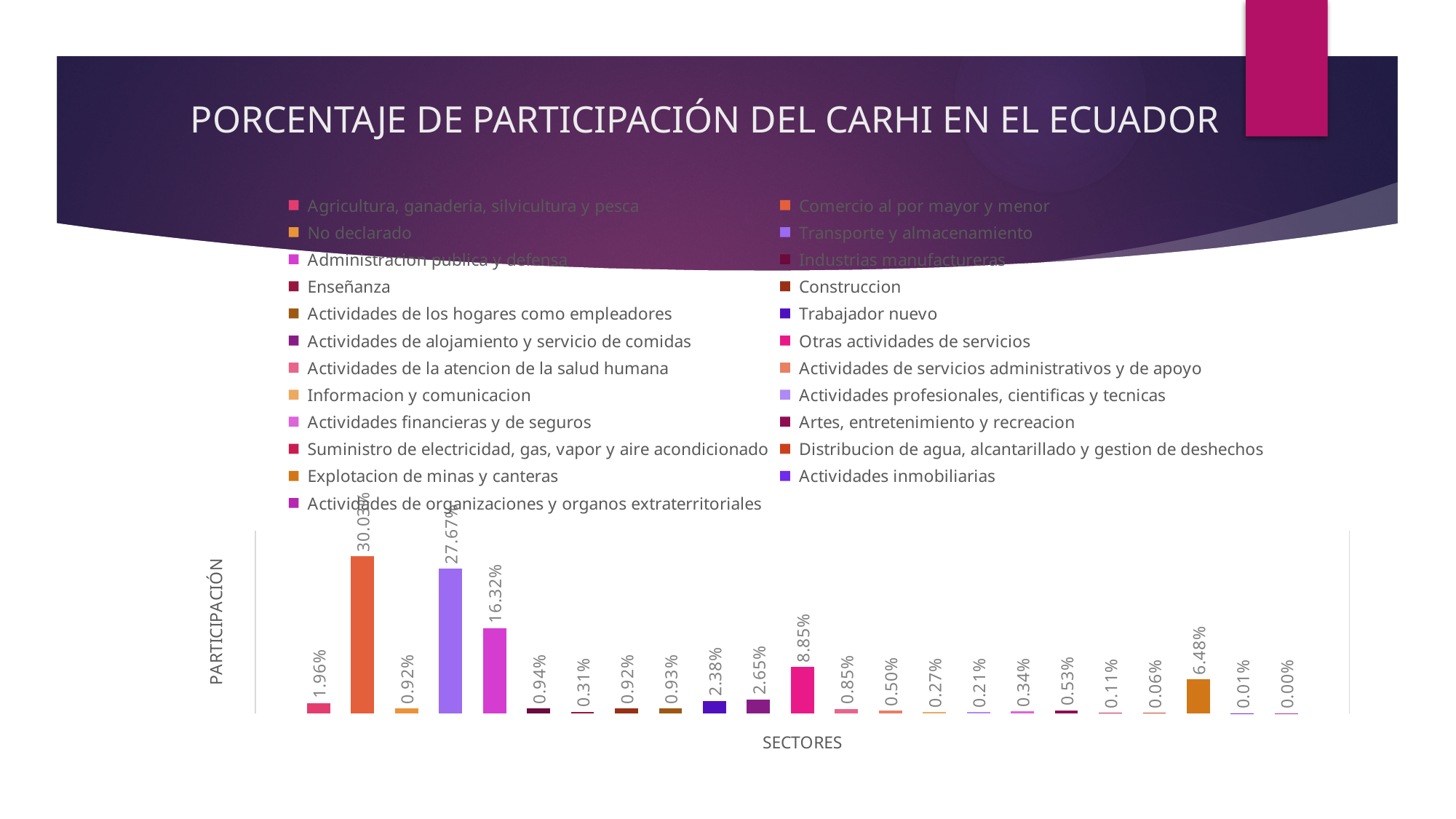
What label is shown on the horizontal axis of the chart? SECTORES What is the title of the slide's chart? PORCENTAJE DE PARTICIPACIÓN DEL CARHI EN EL ECUADOR How many entries does the legend list? 23 What kind of chart is shown on the slide? bar chart What is the value for Administracion publica y defensa? 16.32% What is the difference between the values for Comercio al por mayor y menor and Transporte y almacenamiento? 2.36% What is the lowest value shown on the chart? 0.00% How many bars are plotted on the chart? 23 What is the highest value shown on the chart? 30.03% What is the value for Comercio al por mayor y menor? 30.03% Which is larger, the value for Otras actividades de servicios or the value for Explotacion de minas y canteras? Otras actividades de servicios What is the value for Transporte y almacenamiento? 27.67%